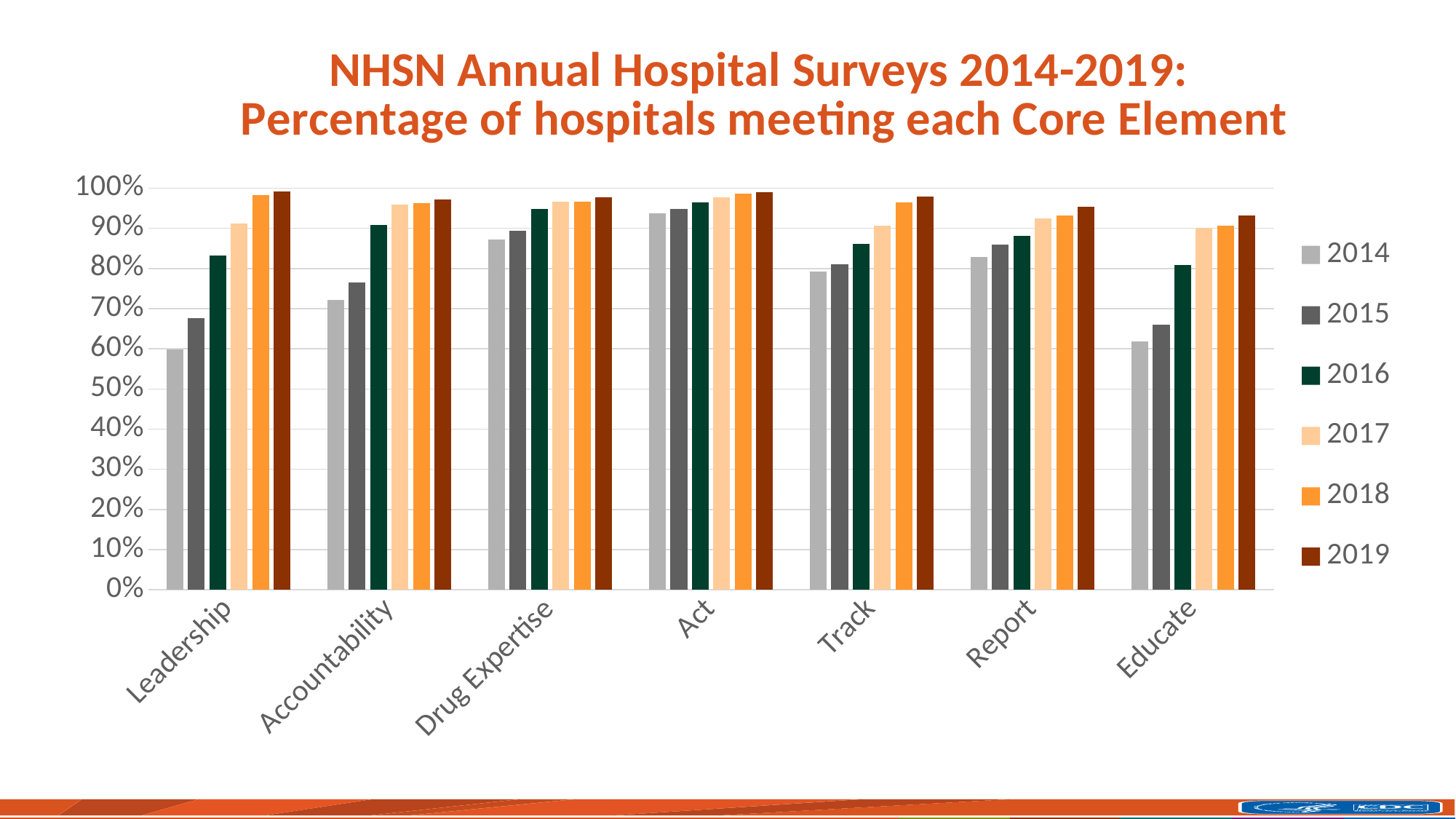
For Leadership, do the values rise or fall from 2014 to 2019? Rise What is the title of the chart? NHSN Annual Hospital Surveys 2014-2019: Percentage of hospitals meeting each Core Element How many series (years) does the legend list? 6 Is the 2014 value for Leadership greater or less than 70%? less Which year is listed first in the legend? 2014 What kind of chart is shown on the slide? Bar chart How many core elements (categories) are shown on the x axis? 7 Which is larger, the 2014 value for Accountability or the 2014 value for Track? Track Is the 2016 value for Educate greater or less than 70%? greater Is the 2017 value for Track greater or less than 80%? greater Which core element has the highest 2014 value? Act